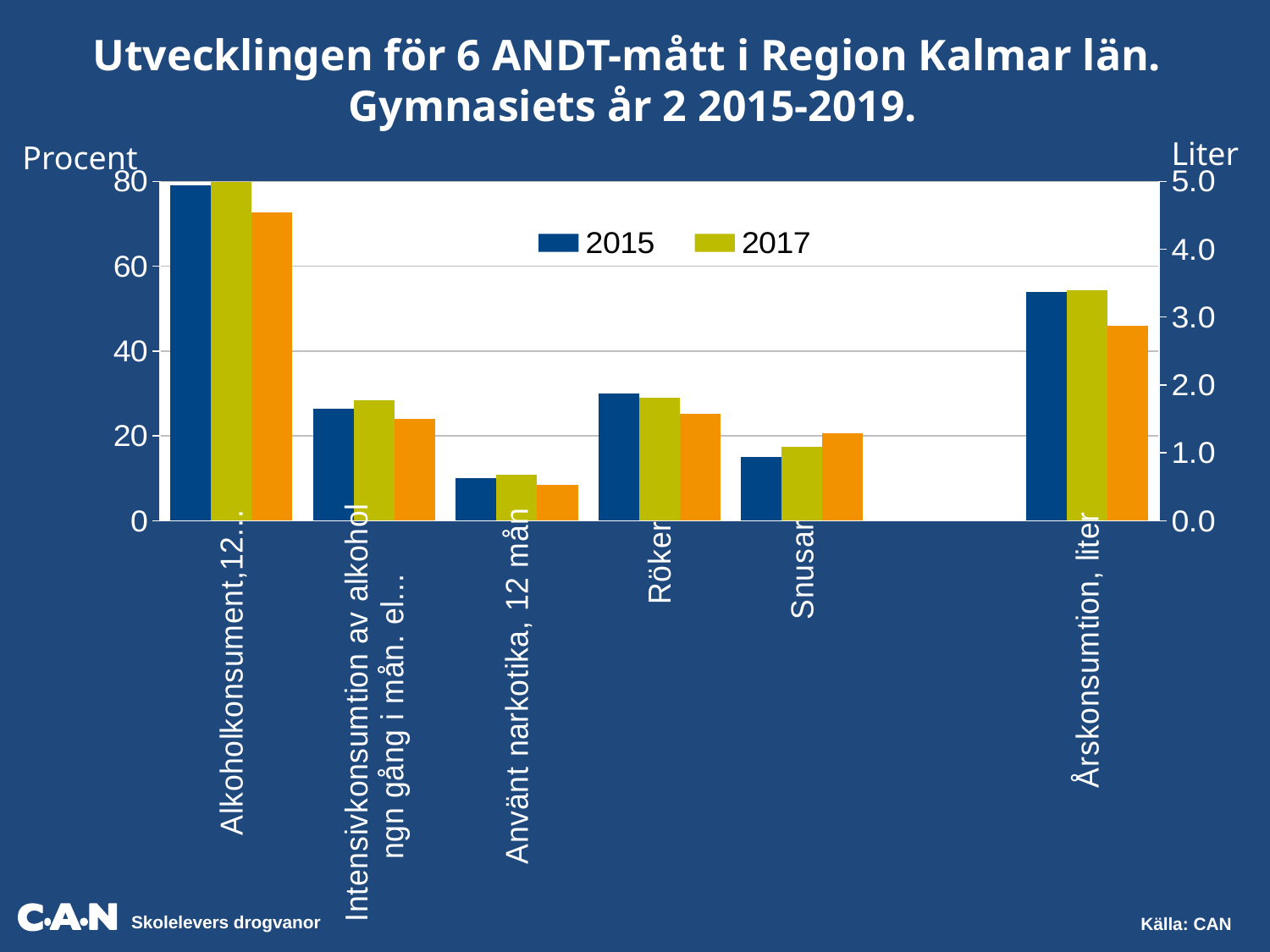
Which category has the lowest 2015 bar? Använt narkotika, 12 mån Is the 2015 value for Årskonsumtion, liter greater or less than 3.0 on the Liter axis? greater What is the label of the left vertical axis? Procent Is the 2017 value for Använt narkotika, 12 mån greater or less than 20? less How many categories are shown along the x axis? 6 How many series does the legend list? 2 What is the label of the right vertical axis? Liter Is the 2015 value for Snusar greater or less than 20? less Which is larger for 2015: Röker or Snusar? Röker What kind of chart is shown on the slide? bar chart